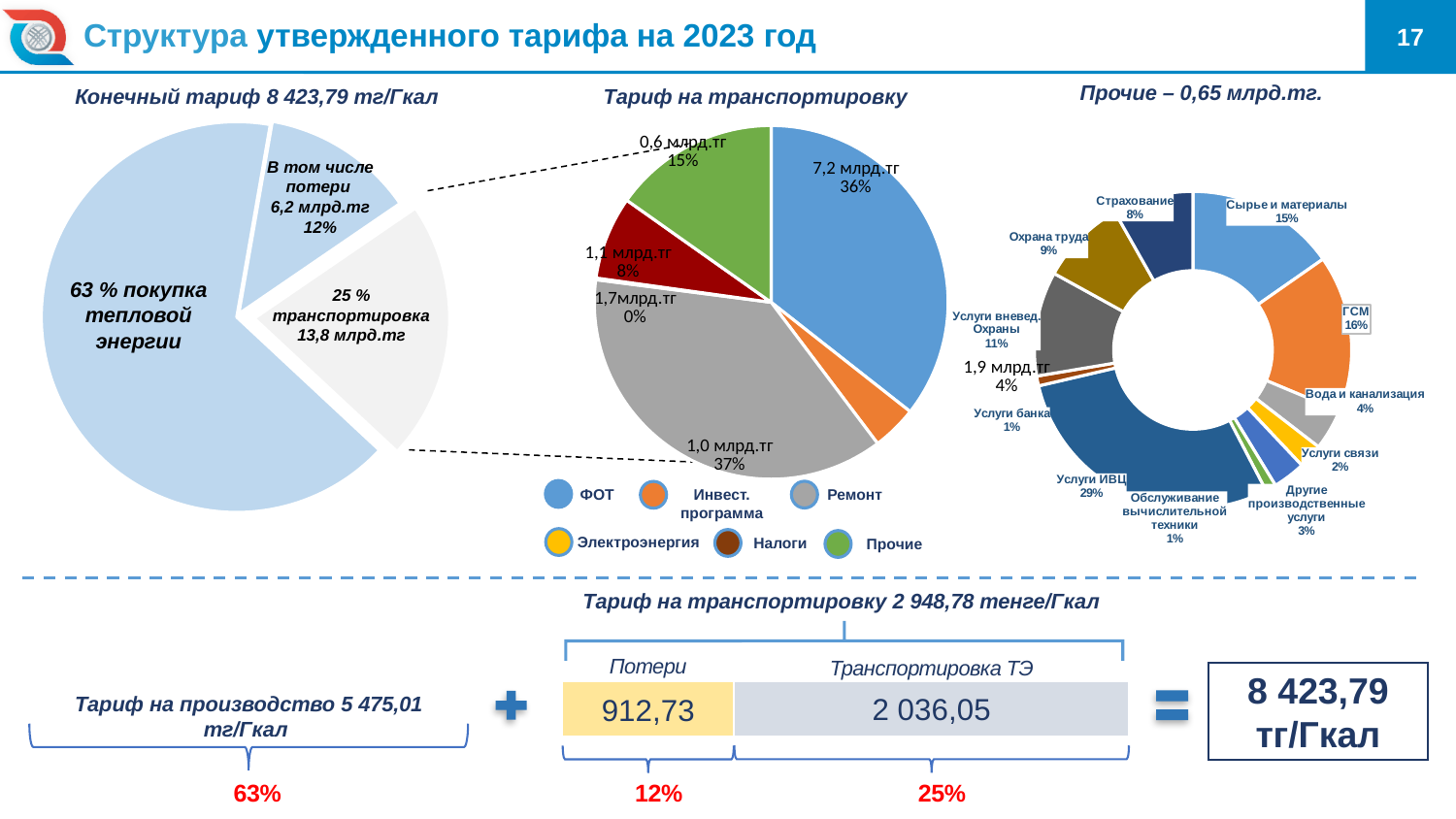
In the left pie chart 'Конечный тариф 8 423,79 тг/Гкал', what percentage is given for 'потери'? 12% In the left pie chart 'Конечный тариф 8 423,79 тг/Гкал', which slice is the largest? покупка тепловой энергии What type of chart is the 'Прочие – 0,65 млрд.тг' chart on the right? Doughnut chart How many entries does the legend of the middle pie chart 'Тариф на транспортировку' list? 6 In the right doughnut chart 'Прочие – 0,65 млрд.тг', how many categories are shown? 11 In the middle pie chart 'Тариф на транспортировку', what value is shown for the ФОТ slice? 7,2 млрд.тг In the right doughnut chart 'Прочие – 0,65 млрд.тг', which category has the largest share? Услуги ИВЦ In the left pie chart 'Конечный тариф 8 423,79 тг/Гкал', what value in млрд.тг is given for 'транспортировка'? 13,8 млрд.тг In the right doughnut chart 'Прочие – 0,65 млрд.тг', what is the share of 'ГСМ'? 16% In the right doughnut chart 'Прочие – 0,65 млрд.тг', which is larger: 'Охрана труда' or 'Страхование'? Охрана труда In the middle pie chart 'Тариф на транспортировку', what percentage is shown next to the 0,6 млрд.тг slice? 15% In the left pie chart 'Конечный тариф 8 423,79 тг/Гкал', what share is labelled 'покупка тепловой энергии'? 63 %